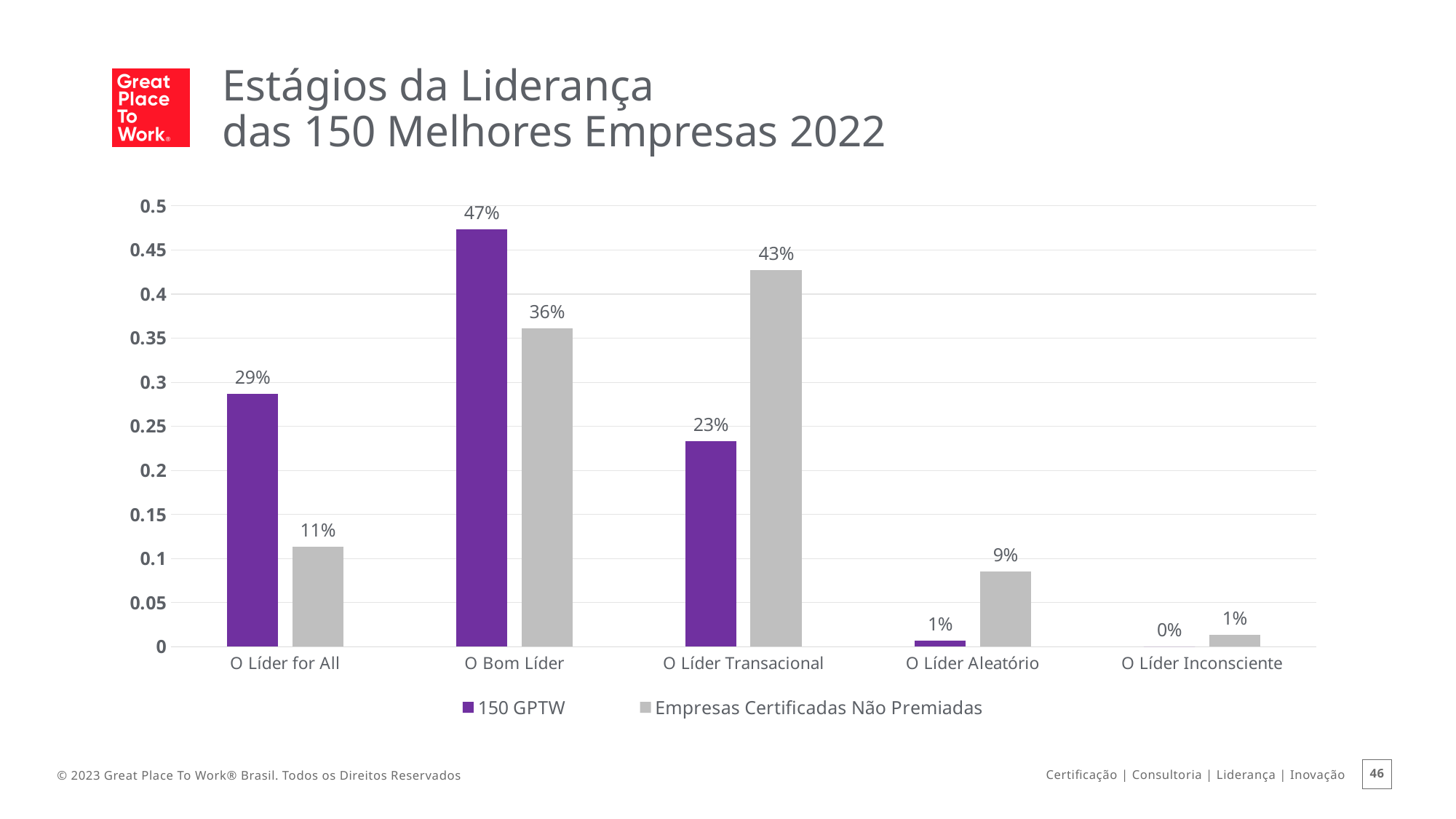
What is the value for Empresas Certificadas Não Premiadas in the O Líder Aleatório category? 9% What is the value for Empresas Certificadas Não Premiadas in the O Líder for All category? 11% What is the value for Empresas Certificadas Não Premiadas in the O Líder Transacional category? 43% How many series does the legend list? 2 What kind of chart is shown on the slide? Bar chart How many categories are shown on the x axis? 5 Which category has the highest value for the 150 GPTW series? O Bom Líder Which colour represents the 150 GPTW series? Purple Which category has the lowest value for the 150 GPTW series? O Líder Inconsciente Which series has the larger value in the O Líder Transacional category? Empresas Certificadas Não Premiadas What is the difference between the 150 GPTW and Empresas Certificadas Não Premiadas values for O Líder for All? 18% What is the value for 150 GPTW in the O Bom Líder category? 47%